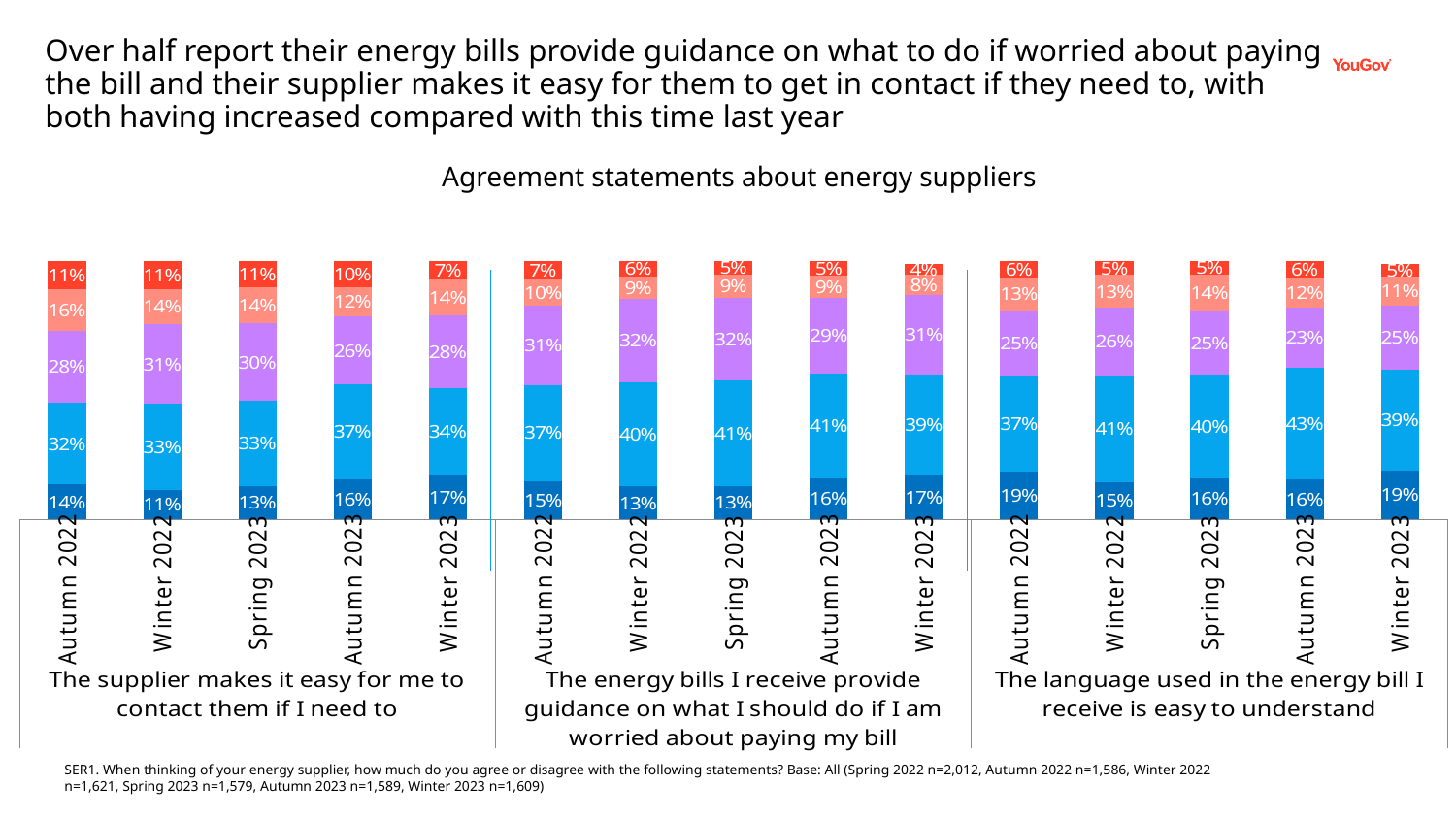
What kind of chart is shown on the slide? Stacked bar chart For the statement 'The energy bills I receive provide guidance on what I should do if I am worried about paying my bill', what is the value of the light blue segment for Spring 2023? 41% For the statement 'The energy bills I receive provide guidance on what I should do if I am worried about paying my bill', what is the difference between the light blue segment values for Autumn 2022 and Winter 2022? 3% How many time periods are shown for each statement? 5 For the statement 'The supplier makes it easy for me to contact them if I need to', is the purple segment larger in Winter 2022 or Autumn 2023? Winter 2022 For the statement 'The supplier makes it easy for me to contact them if I need to', what is the value of the bottom (dark blue) segment for Winter 2023? 17% What is the title of the chart? Agreement statements about energy suppliers For the statement 'The language used in the energy bill I receive is easy to understand', which period has the highest light blue segment value? Autumn 2023 For the statement 'The supplier makes it easy for me to contact them if I need to', which period has the lowest top (red) segment value? Winter 2023 For the statement 'The language used in the energy bill I receive is easy to understand', what is the combined value of the bottom two segments (dark blue and light blue) for Winter 2023? 58% For the statement 'The language used in the energy bill I receive is easy to understand', what is the value of the top (red) segment for Autumn 2023? 6% How many statements (groups of bars) does the chart cover? 3